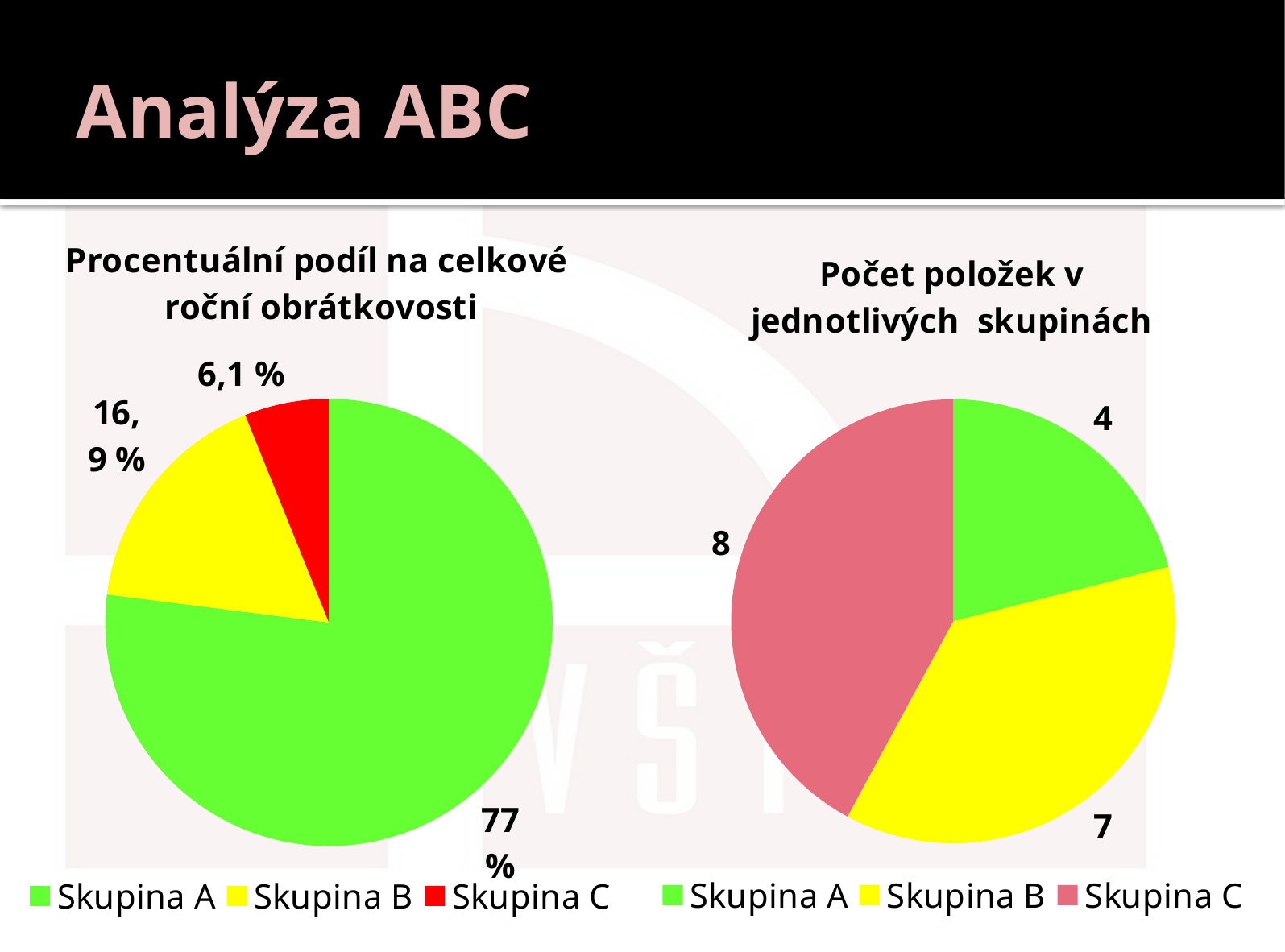
What type of chart is the left chart (Procentuální podíl na celkové roční obrátkovosti)? Pie chart In the left chart (Procentuální podíl na celkové roční obrátkovosti), what is the value for Skupina A? 77 % How many slices does the right chart (Počet položek v jednotlivých skupinách) have? 3 In the left chart (Procentuální podíl na celkové roční obrátkovosti), which group has the smallest share? Skupina C In the right chart (Počet položek v jednotlivých skupinách), how many items are in Skupina C? 8 In the right chart (Počet položek v jednotlivých skupinách), how many items are in Skupina A? 4 In the right chart (Počet položek v jednotlivých skupinách), what is the difference between the number of items in Skupina B and Skupina A? 3 In the right chart (Počet položek v jednotlivých skupinách), which group has the most items? Skupina C In the left chart (Procentuální podíl na celkové roční obrátkovosti), what is the value for Skupina B? 16,9 % In the right chart (Počet položek v jednotlivých skupinách), which has more items, Skupina B or Skupina A? Skupina B In the right chart (Počet položek v jednotlivých skupinách), what colour is the slice for Skupina C? Pink/red In the left chart (Procentuální podíl na celkové roční obrátkovosti), what is the value for Skupina C? 6,1 %